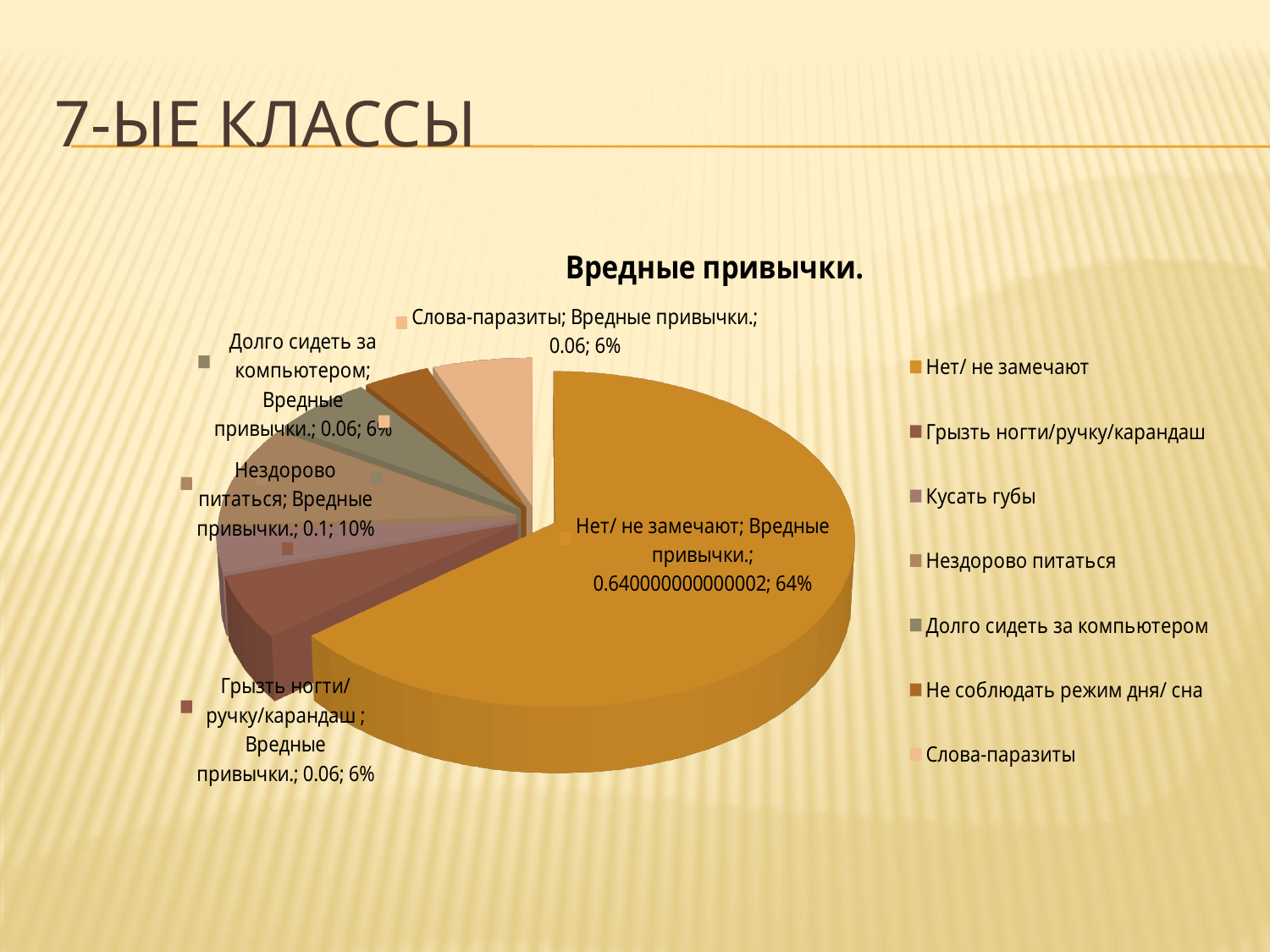
What is the difference in percentage points between the 'Нет/ не замечают' slice and the 'Нездорово питаться' slice? 54% Which category has the largest slice of the pie? Нет/ не замечают What kind of chart is shown on the slide? pie chart Which legend entry is listed first in the chart legend? Нет/ не замечают What is the title of the chart? Вредные привычки. What share of the pie is labelled for 'Слова-паразиты'? 6% What share of the pie is labelled for 'Грызть ногти/ручку/карандаш'? 6% Which is larger: the slice for 'Нездорово питаться' or the slice for 'Слова-паразиты'? Нездорово питаться How many entries does the chart legend list? 7 What share of the pie is labelled for 'Долго сидеть за компьютером'? 6%